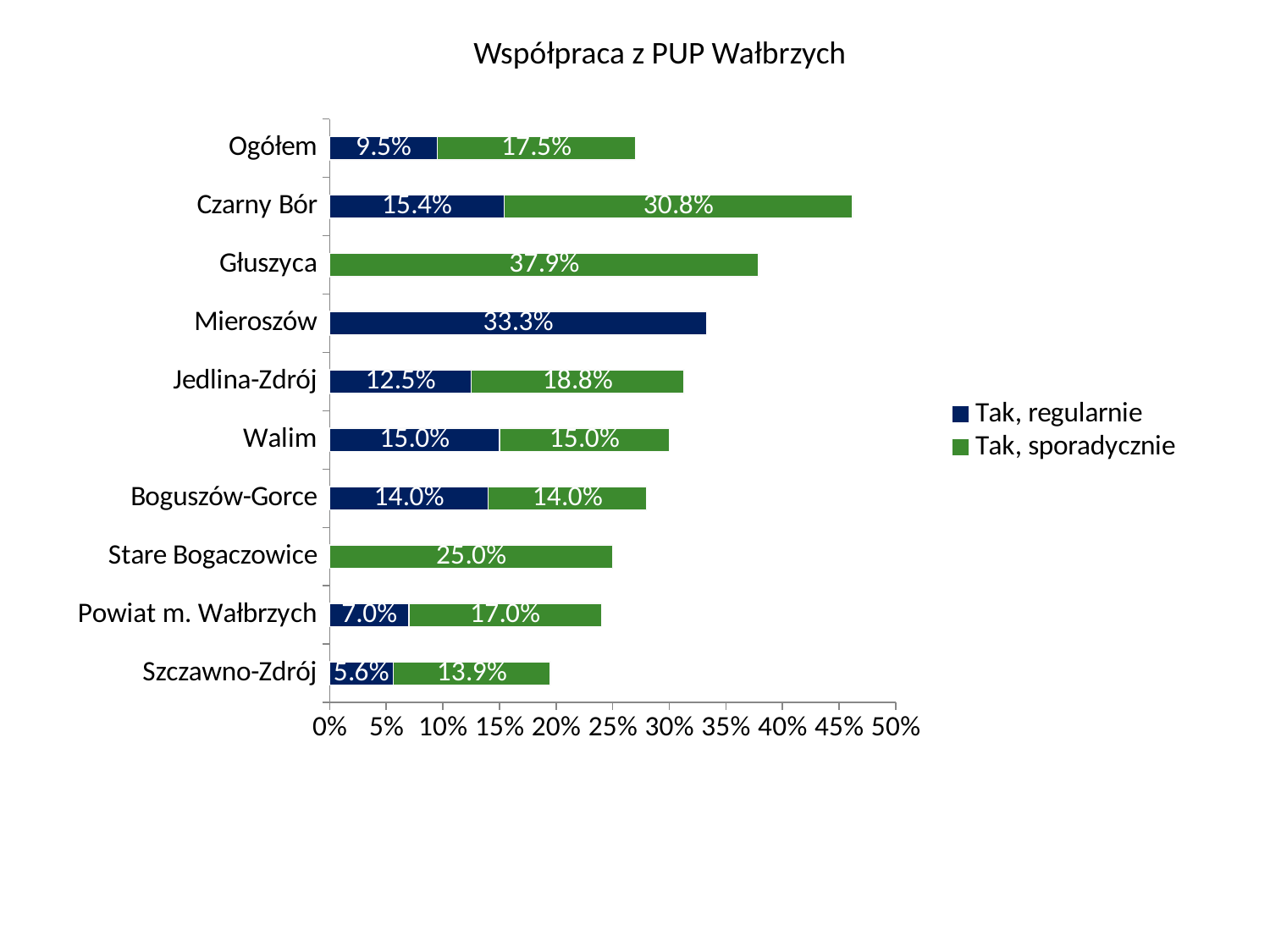
What is the value of "Tak, sporadycznie" for Głuszyca? 37.9% What is the value of "Tak, sporadycznie" for Szczawno-Zdrój? 13.9% What is the value of "Tak, regularnie" for Czarny Bór? 15.4% Which is larger: the "Tak, regularnie" value for Jedlina-Zdrój or for Powiat m. Wałbrzych? Jedlina-Zdrój What is the difference between the "Tak, sporadycznie" values for Czarny Bór and Ogółem? 13.3% What kind of chart is shown on the slide? Stacked bar chart How many series does the legend list? 2 How many categories are shown on the chart? 10 Which category has the highest value for "Tak, sporadycznie"? Głuszyca Which category has the lowest value for "Tak, regularnie"? Szczawno-Zdrój What is the total of the stacked bar for Czarny Bór? 46.2% What is the value of "Tak, regularnie" for Mieroszów? 33.3%